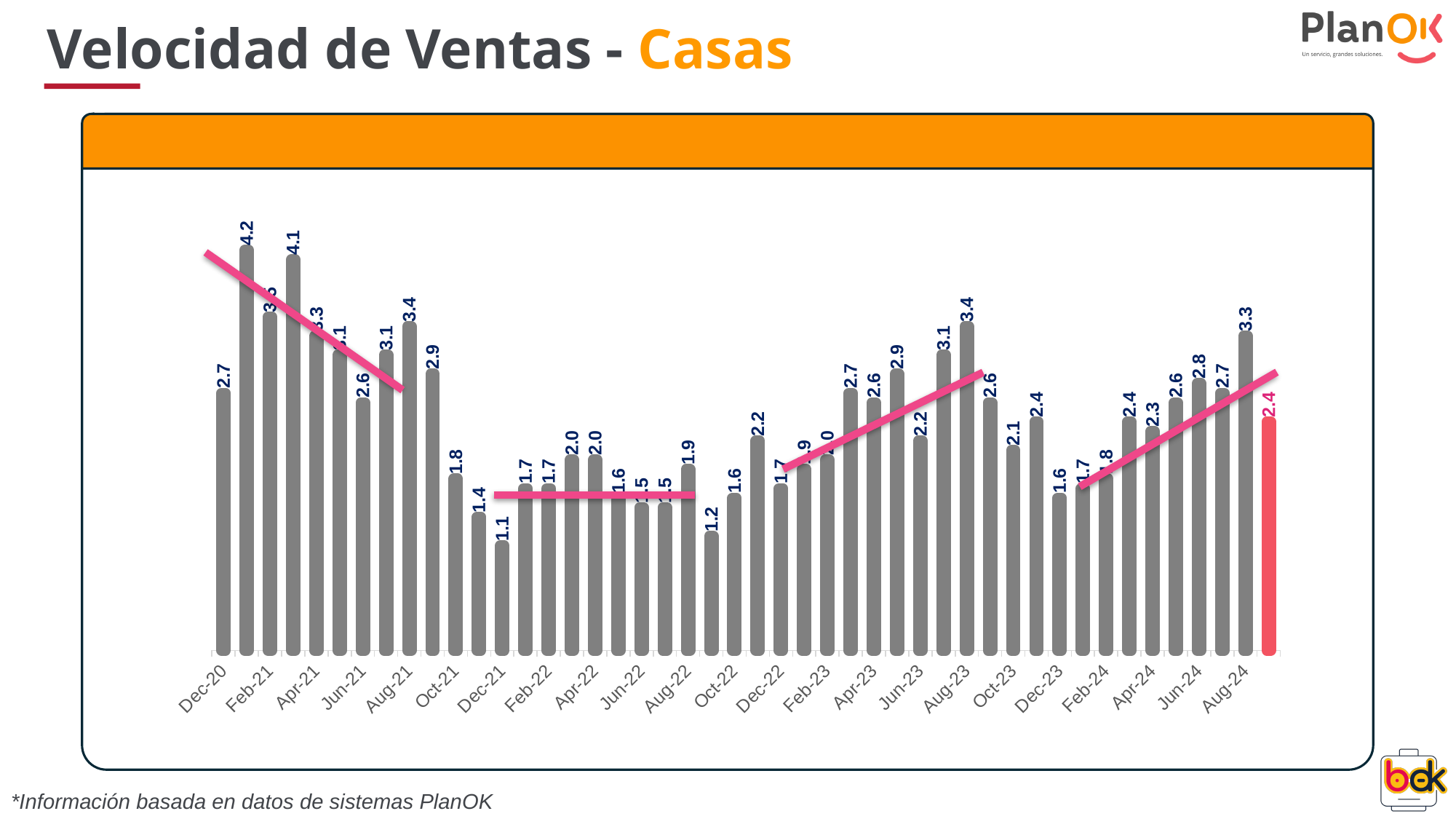
What is the value for Aug-24? 3.3 Which month has the lowest value in the chart? Dec-21 What is the value for Dec-21? 1.1 Do the values rise or fall from Aug-21 to Dec-21? fall Which is larger, the value for Apr-21 or the value for Apr-23? Apr-21 What is the difference between the values for Aug-24 and Dec-23? 1.7 What is the highest value shown in the chart? 4.2 What is the value for Jun-24? 2.8 What is the value for Dec-20? 2.7 What colour is the last bar in the chart? red What kind of chart is shown on the slide? bar chart What is the value for Aug-23? 3.4